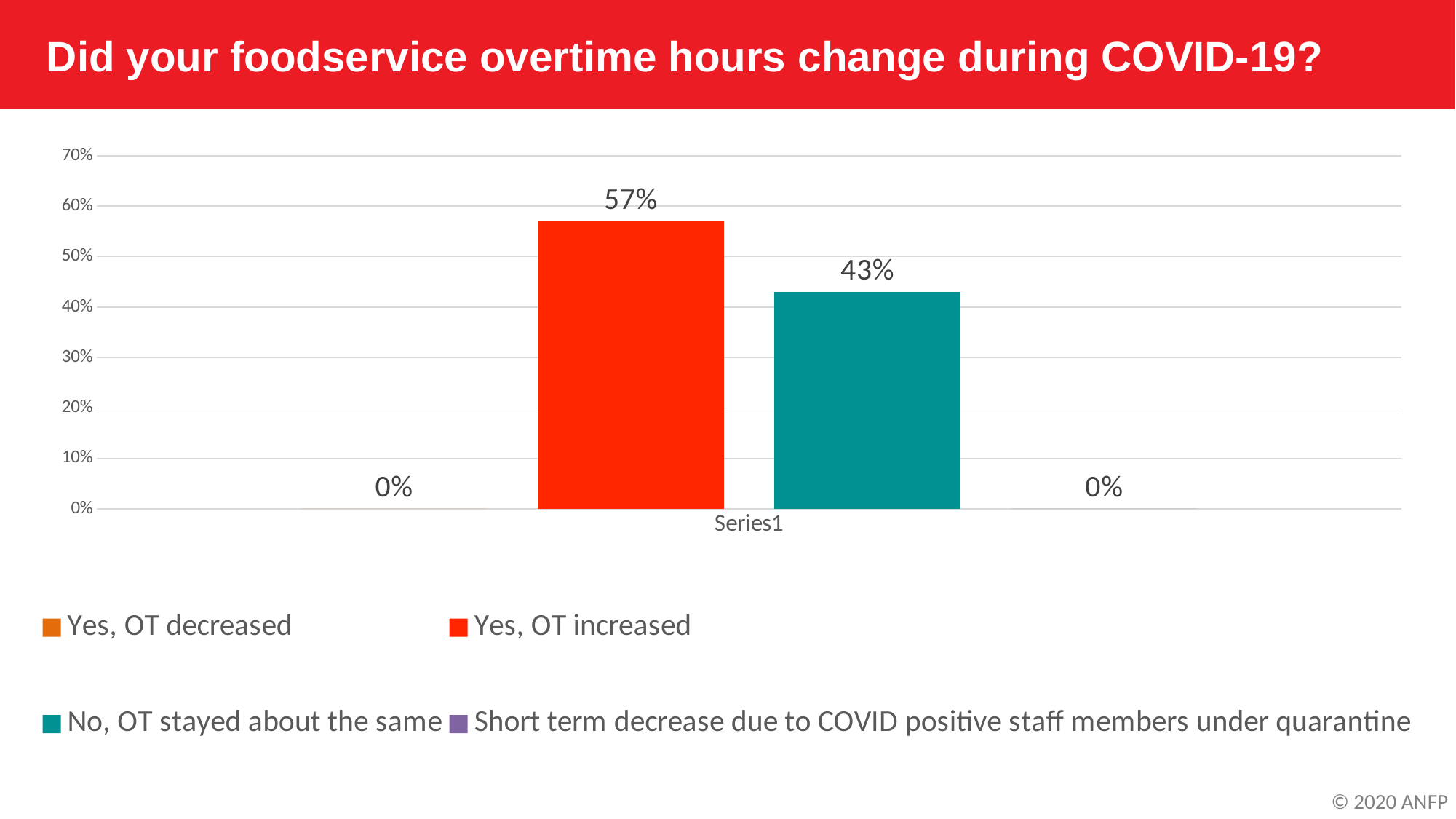
What percentage of respondents said their OT decreased? 0% Is the value for 'No, OT stayed about the same' greater or less than 50%? less How many series does the legend list? 4 What colour is the bar for 'No, OT stayed about the same'? teal Which response has the highest percentage? Yes, OT increased What is the difference in percentage points between 'Yes, OT increased' and 'No, OT stayed about the same'? 14% What percentage of respondents said OT stayed about the same? 43% What kind of chart is shown on the slide? bar chart What percentage of respondents said their OT increased? 57% What is the title of the chart? Did your foodservice overtime hours change during COVID-19? Which is larger: 'Yes, OT increased' or 'No, OT stayed about the same'? Yes, OT increased What percentage of respondents reported a short term decrease due to COVID positive staff members under quarantine? 0%